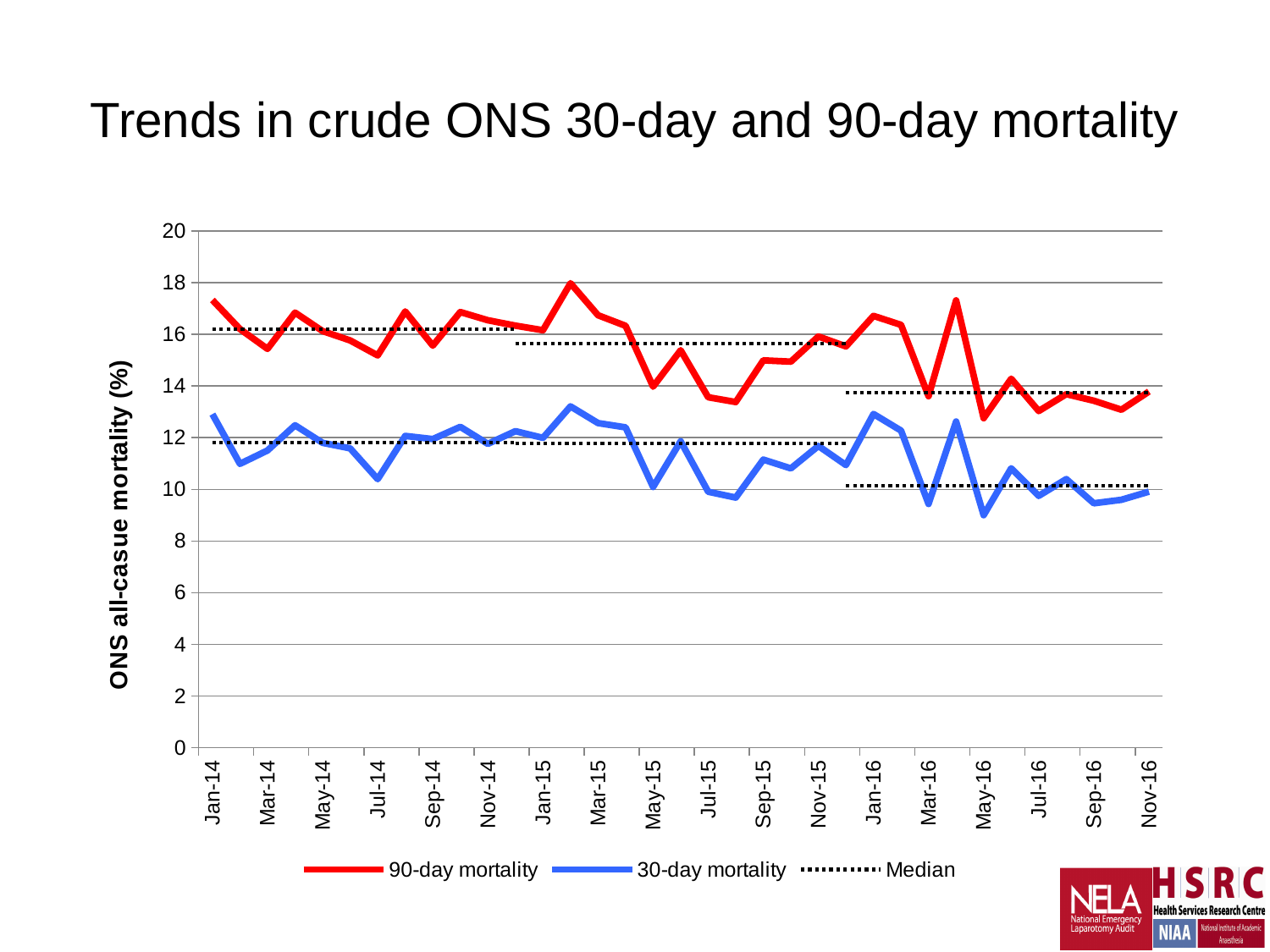
What is the title of the chart? Trends in crude ONS 30-day and 90-day mortality Is the value for 30-day mortality in May-16 greater or less than 10? less Is the value for 30-day mortality in Nov-16 greater or less than 12? less Is the value for 30-day mortality in Jan-14 greater or less than 12? greater How many series does the legend list? 3 Which is larger in Jan-14, 90-day mortality or 30-day mortality? 90-day mortality Which series is drawn as a dotted line? Median Does 90-day mortality generally rise or fall from Jan-14 to Nov-16? Fall Does 30-day mortality generally rise or fall from Jan-14 to Nov-16? Fall What kind of chart is shown on the slide? Line chart